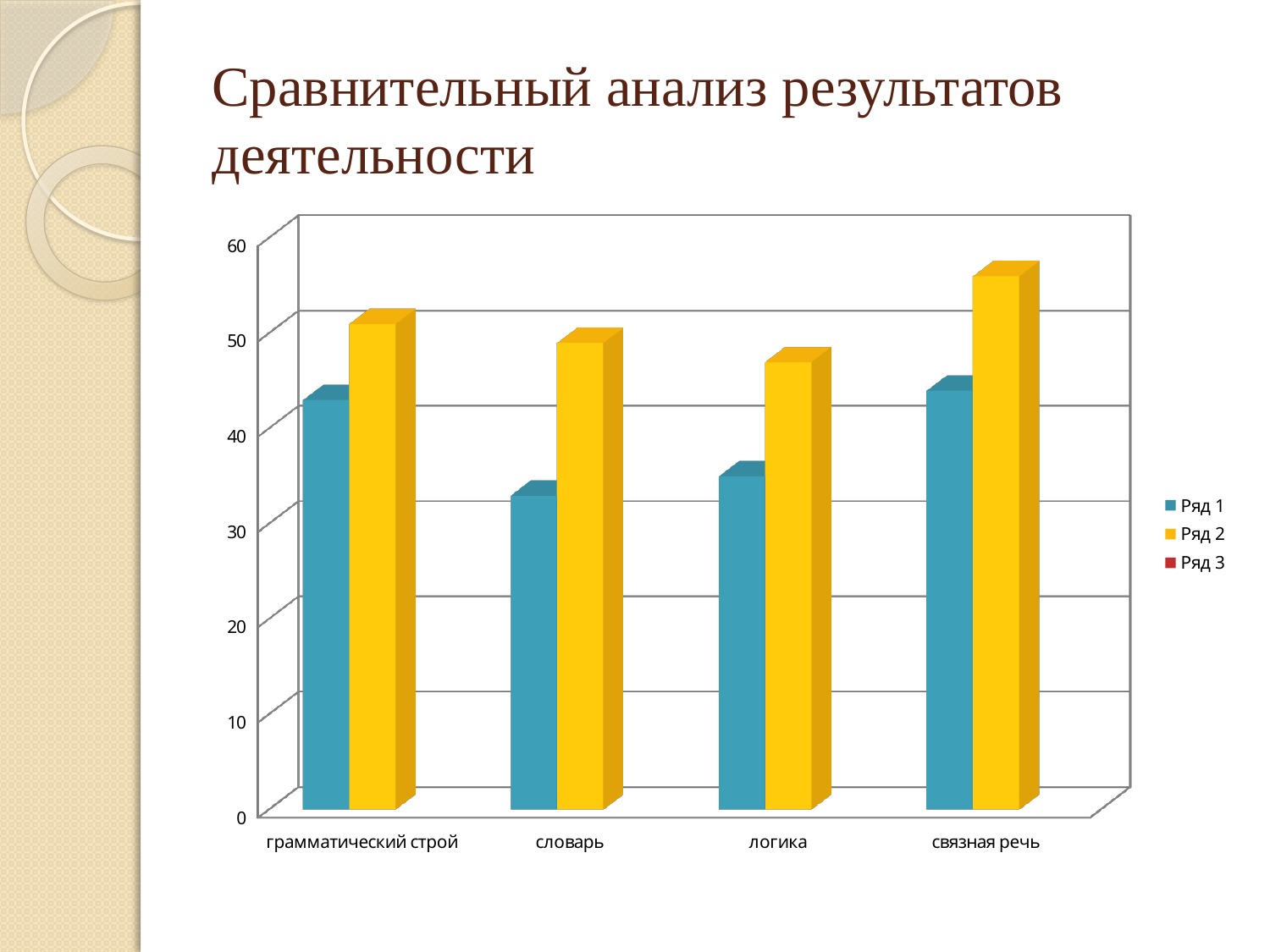
What kind of chart is shown on the slide? bar chart Is the value of Ряд 1 for словарь greater or less than 40? less Is the value of Ряд 1 for логика greater or less than 40? less Is the value of Ряд 2 for логика greater or less than 50? less How many categories are shown on the x axis of the chart? 4 Which category has the highest value for Ряд 2? связная речь For словарь, which series has the larger value, Ряд 1 or Ряд 2? Ряд 2 How many series does the chart's legend list? 3 What is the title of the slide containing the chart? Сравнительный анализ результатов деятельности Which legend entry is shown in yellow? Ряд 2